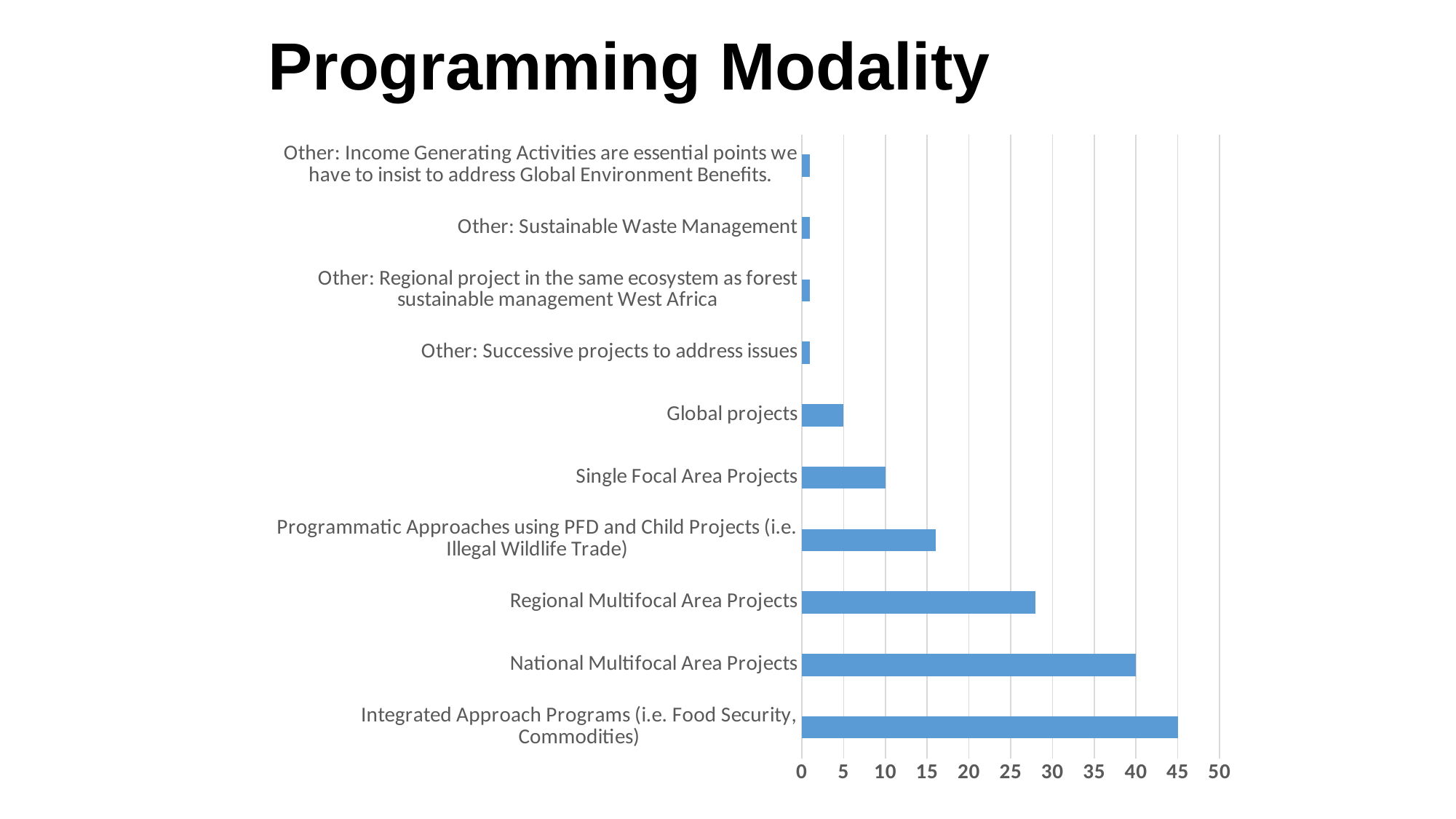
What kind of chart is shown on the slide? bar chart How many categories are plotted in the chart? 10 Is the value for Regional Multifocal Area Projects greater or less than 25? greater Which is larger, the value for National Multifocal Area Projects or Regional Multifocal Area Projects? National Multifocal Area Projects What is the value for National Multifocal Area Projects? 40 Is the value for Programmatic Approaches using PFD and Child Projects (i.e. Illegal Wildlife Trade) greater or less than 20? less What is the title of the chart? Programming Modality Which category has the highest value? Integrated Approach Programs (i.e. Food Security, Commodities) What is the value for Integrated Approach Programs (i.e. Food Security, Commodities)? 45 What is the value for Single Focal Area Projects? 10 What is the value for Global projects? 5 What is the difference between the values for Integrated Approach Programs and National Multifocal Area Projects? 5